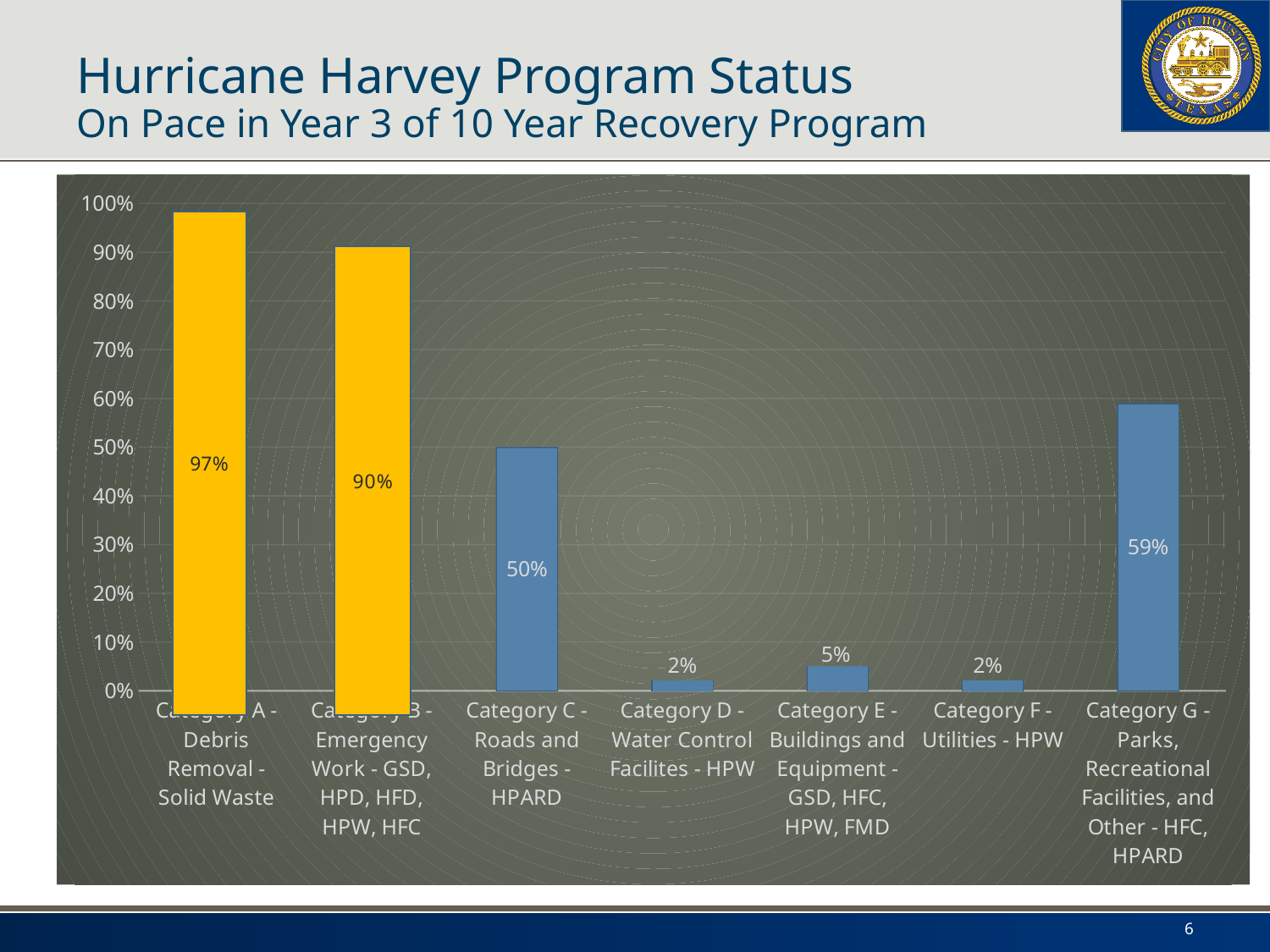
Which category has the highest value? Category A - Debris Removal - Solid Waste Which two categories have bars coloured yellow? Category A and Category B What kind of chart is shown on the slide? bar chart How many categories are shown on the chart? 7 What is the difference between the values for Category A and Category B? 7% What is the value for Category A - Debris Removal - Solid Waste? 97% What is the value for Category G - Parks, Recreational Facilities, and Other - HFC, HPARD? 59% Which is larger, the value for Category C or the value for Category G? Category G Is the value for Category B greater or less than 80%? greater What is the difference between the values for Category G and Category C? 9% What is the value for Category E - Buildings and Equipment - GSD, HFC, HPW, FMD? 5% What is the value for Category C - Roads and Bridges - HPARD? 50%